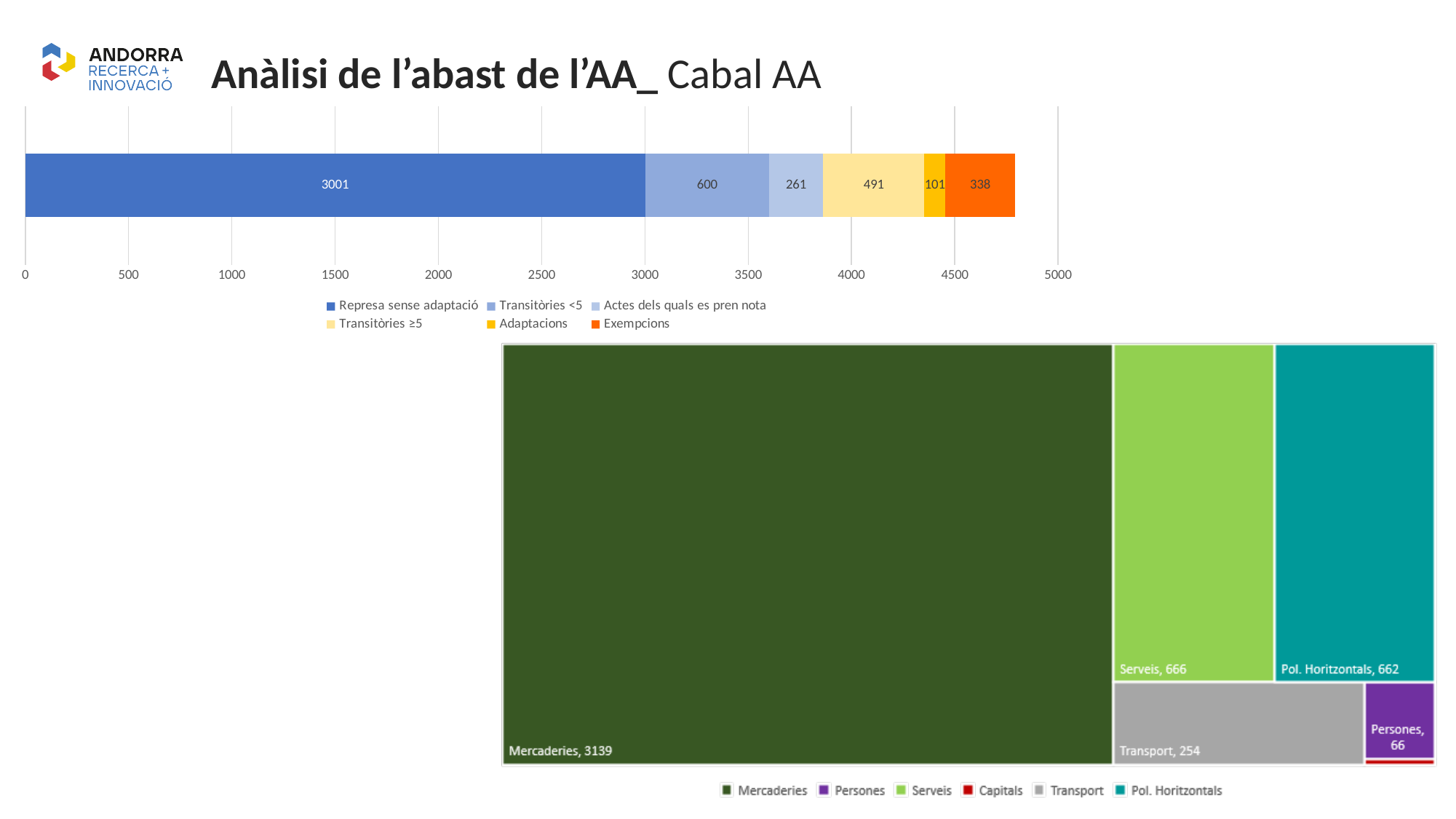
In the bottom treemap chart, what is the value for Transport? 254 How many series does the legend of the top stacked bar chart list? 6 How many categories does the legend of the bottom treemap chart list? 6 In the bottom treemap chart, which is larger, Serveis or Pol. Horitzontals? Serveis In the bottom treemap chart, what is the value for Mercaderies? 3139 In the top stacked bar chart, what is the total of all segments in the bar? 4792 In the top stacked bar chart, what is the difference between Transitòries <5 and Transitòries ≥5? 109 In the top stacked bar chart, what is the value for Exempcions? 338 In the top stacked bar chart, what is the value for Represa sense adaptació? 3001 In the bottom treemap chart, what is the difference between Mercaderies and Serveis? 2473 What kind of chart is the top chart on the slide? Stacked bar chart In the top stacked bar chart, which series has the smallest value? Adaptacions